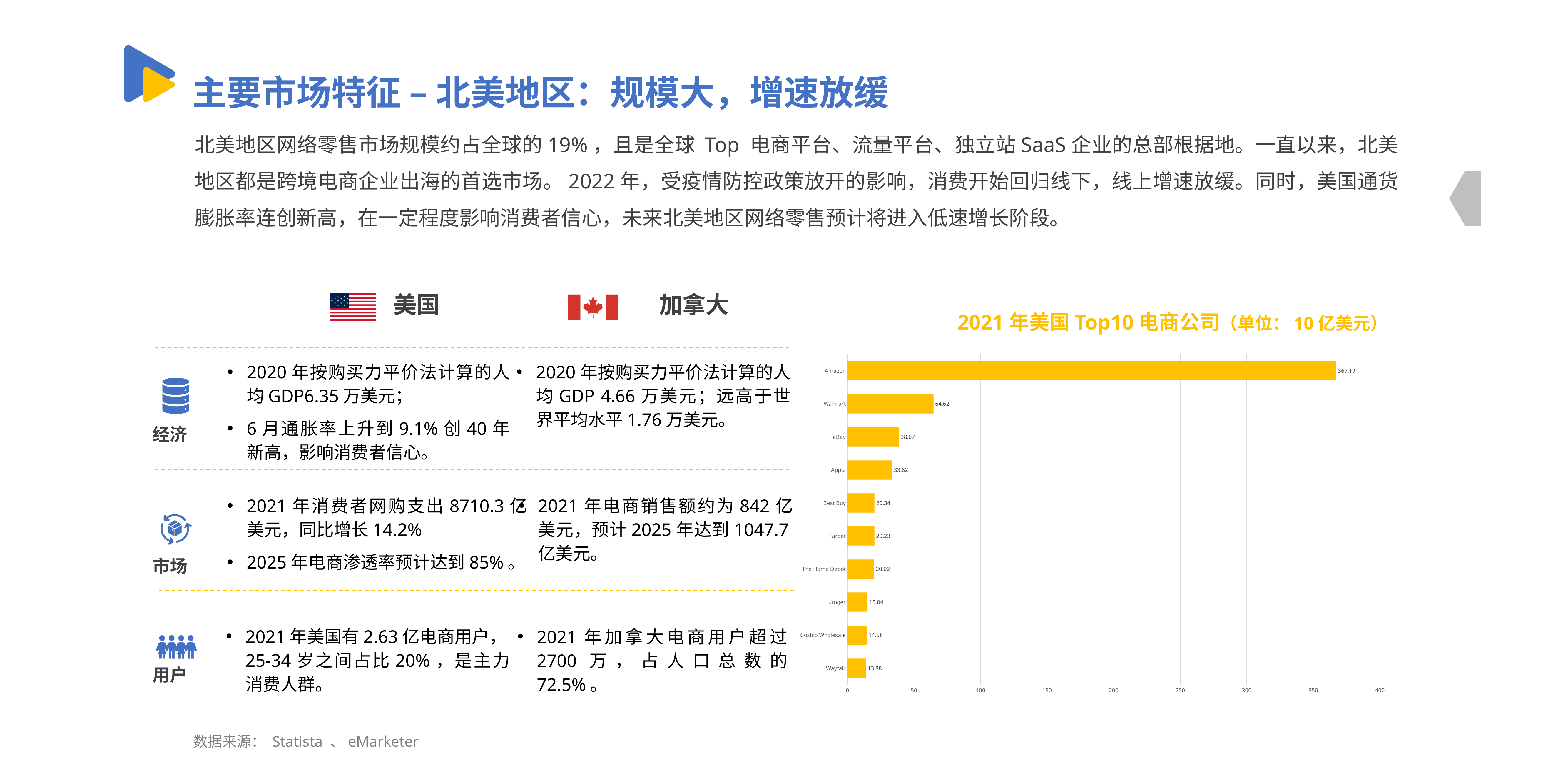
What is the value for Wayfair in the chart? 13.88 Is the value for Walmart greater or less than 50? greater Which company has the lowest value in the chart? Wayfair What is the value for eBay in the chart? 38.67 What is the value for Amazon in the chart? 367.19 What is the title of the chart? 2021 年美国 Top10 电商公司（单位：10 亿美元） What is the value for Walmart in the chart? 64.62 What kind of chart is shown on the slide? Bar chart Which has a larger value, Apple or Best Buy? Apple What is the difference between the values for Amazon and Walmart? 302.57 Which company has the highest value in the chart? Amazon How many companies are shown in the chart? 10